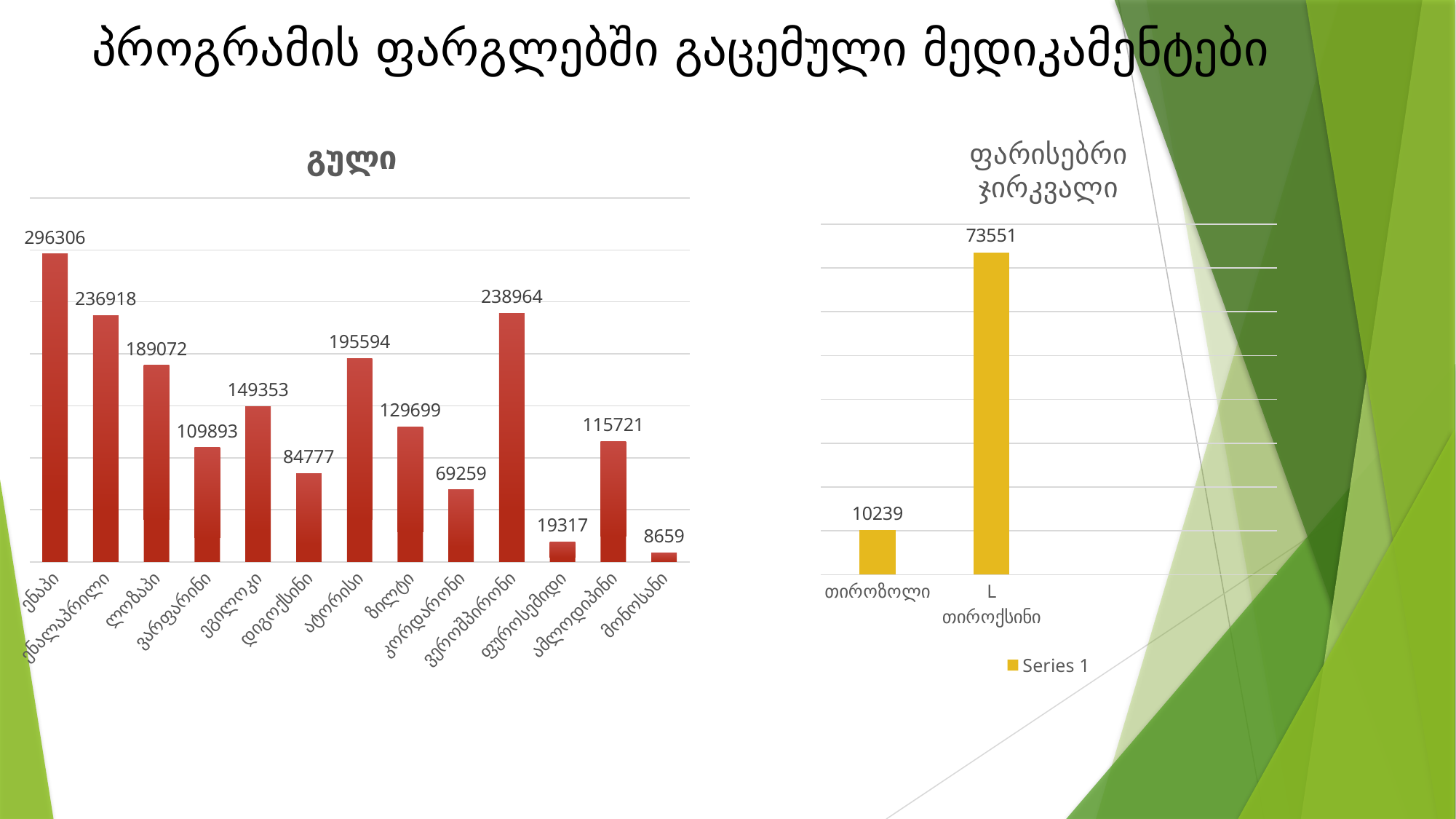
In the chart titled "გული", what is the value for ენაპი? 296306 What is the legend entry shown in the chart titled "ფარისებრი ჯირკვალი"? Series 1 In the chart titled "ფარისებრი ჯირკვალი", what is the difference between the values for L თიროქსინი and თიროზოლი? 63312 In the chart titled "ფარისებრი ჯირკვალი", what is the value for L თიროქსინი? 73551 In the chart titled "გული", what is the difference between the values for ენაპი and ენალაპრილი? 59388 How many series does the legend of the chart titled "ფარისებრი ჯირკვალი" list? 1 What kind of chart is the chart titled "გული"? bar chart In the chart titled "გული", what is the value for ვეროშპირონი? 238964 In the chart titled "გული", which category has the highest value? ენაპი In the chart titled "გული", which is larger, the value for ატორისი or the value for ლოზაპი? ატორისი How many categories are shown in the chart titled "გული"? 13 In the chart titled "გული", which category has the lowest value? მონოსანი